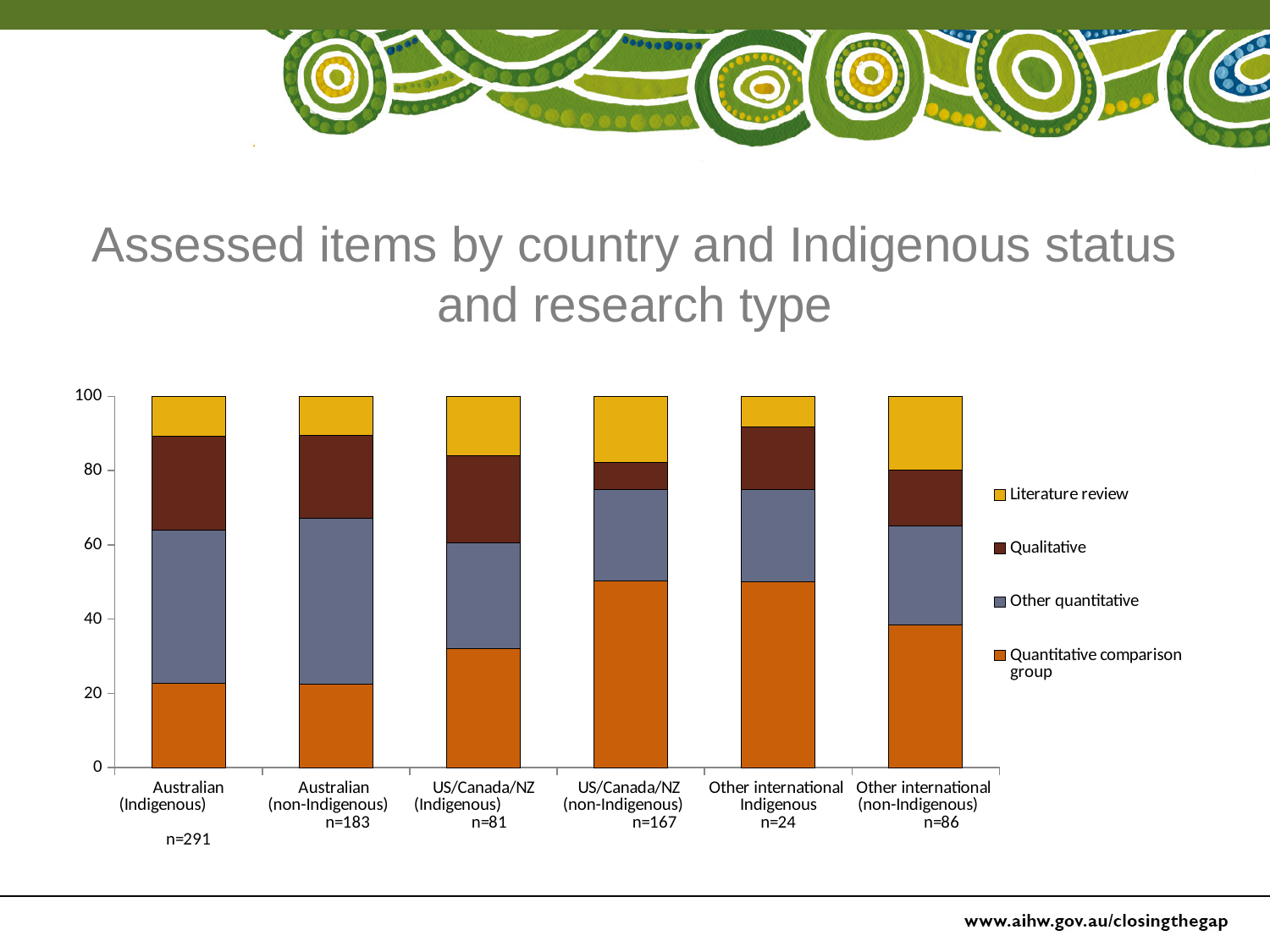
Is the Quantitative comparison group value for Other international (non-Indigenous) greater or less than 60? less What is the total height of each stacked bar in the chart? 100 Is the Quantitative comparison group value for US/Canada/NZ (Indigenous) greater or less than 40? less What kind of chart is shown on the slide? Stacked bar chart Is the Quantitative comparison group value for Australian (Indigenous) greater or less than 40? less What is the title of the chart on the slide? Assessed items by country and Indigenous status and research type Which has the larger Other quantitative share: Australian (non-Indigenous) or Other international Indigenous? Australian (non-Indigenous) How many categories are shown along the x axis of the chart? 6 How many series does the chart's legend list? 4 Which has the larger Quantitative comparison group share: Australian (Indigenous) or US/Canada/NZ (Indigenous)? US/Canada/NZ (Indigenous) What sample size is shown for the Australian (Indigenous) category? n=291